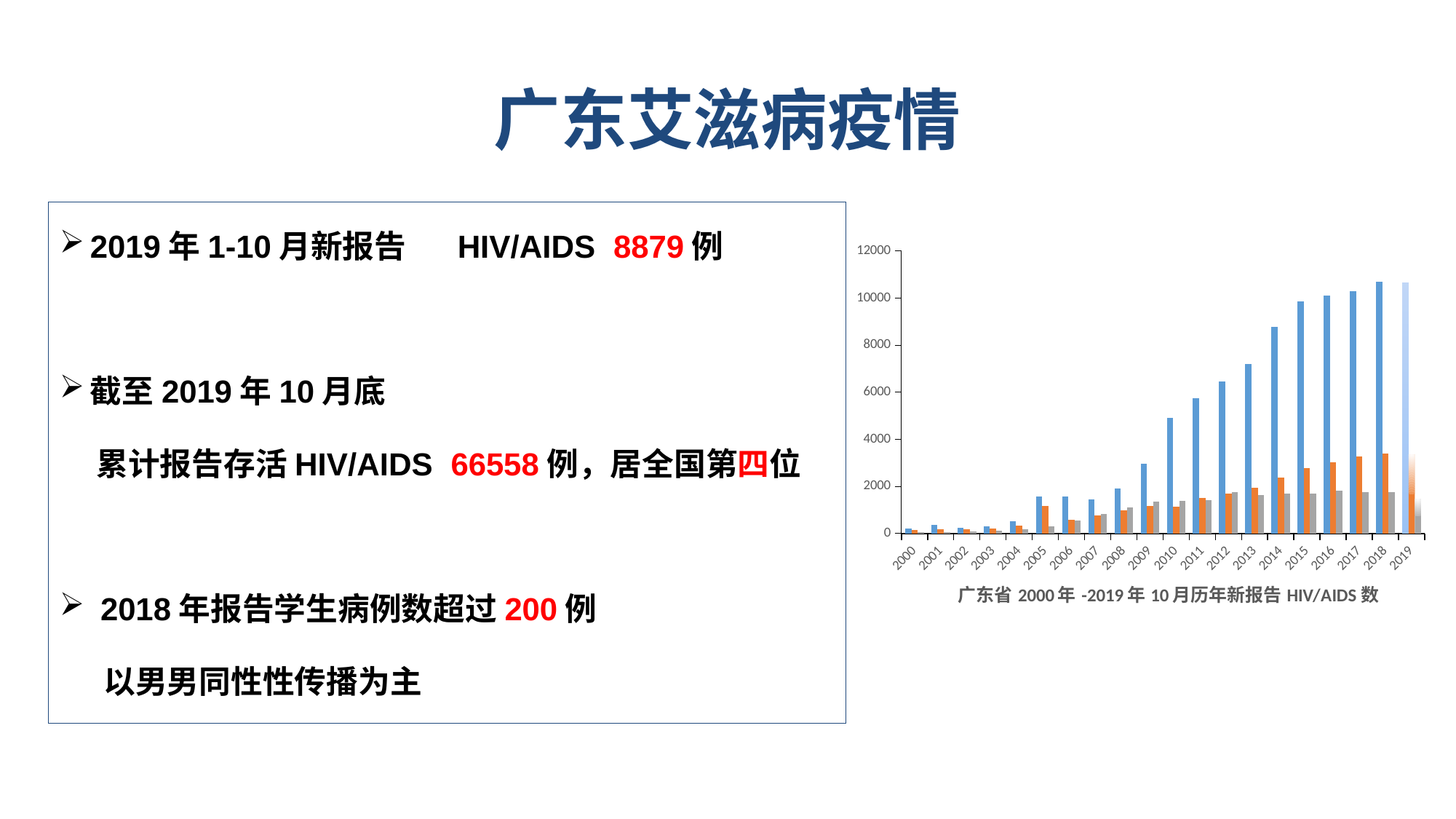
Is the value of the orange bar for 2005 greater or less than 2000? less What kind of chart is shown on the right of the slide? bar chart Is the value of the blue bar for 2015 greater or less than 8000? greater Which year has the larger orange bar, 2010 or 2017? 2017 Do the blue bars generally rise or fall from 2000 to 2018? rise How many differently coloured bar series are plotted for each year in the chart? 3 How many years are shown on the x axis of the chart? 20 What is the caption/title printed under the chart? 广东省2000年-2019年10月历年新报告HIV/AIDS数 Is the value of the blue bar for 2010 greater or less than 4000? greater Which year has the larger blue bar, 2010 or 2018? 2018